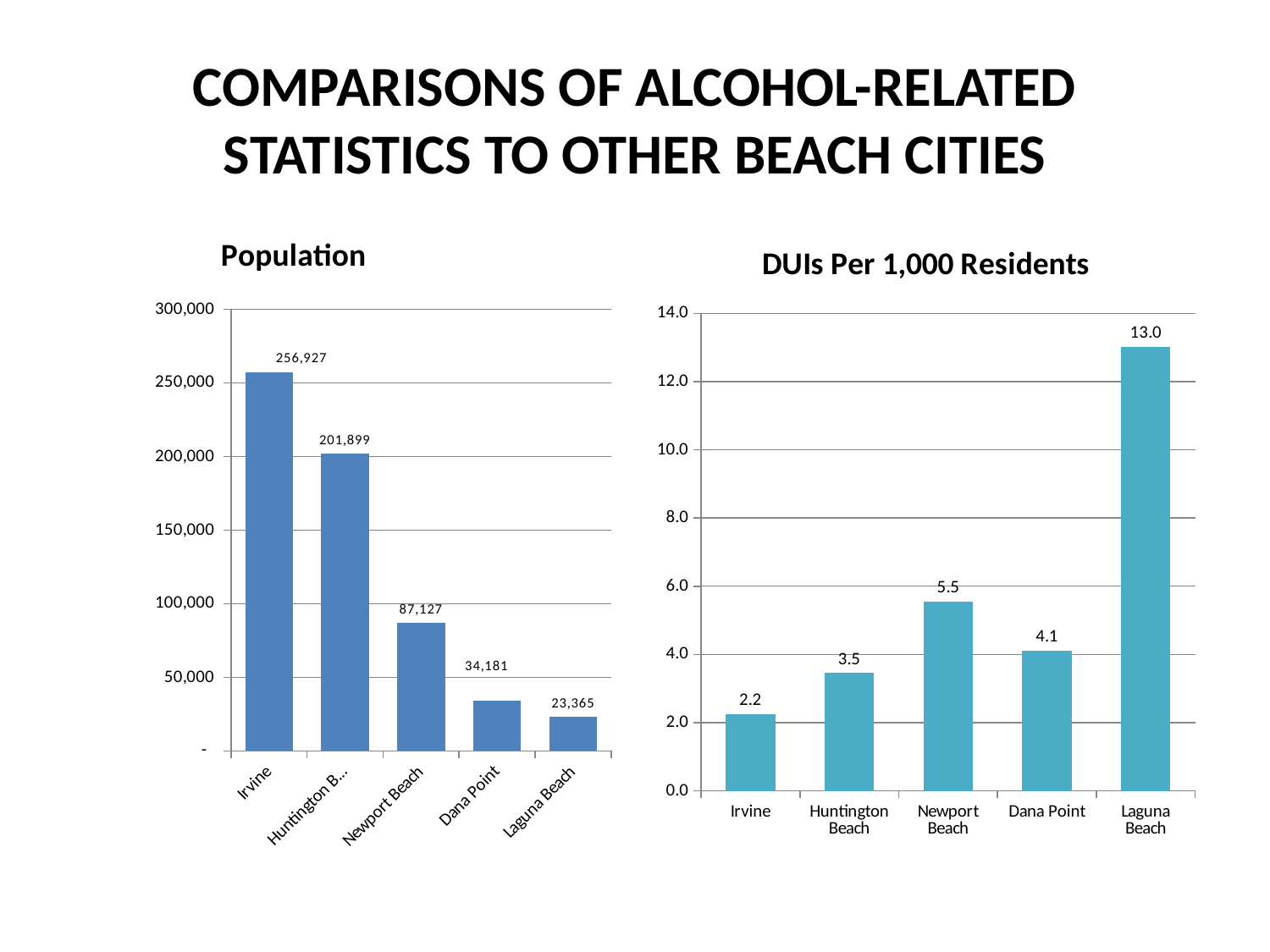
In the DUIs Per 1,000 Residents chart, what is the value for Laguna Beach? 13.0 In the Population chart, which city has the lowest population? Laguna Beach In the Population chart, is the value for Newport Beach greater or less than 100,000? less In the DUIs Per 1,000 Residents chart, what is the value for Newport Beach? 5.5 In the Population chart, what is the population of Newport Beach? 87,127 In the Population chart, what is the population of Irvine? 256,927 How many cities are shown in the DUIs Per 1,000 Residents chart? 5 In the DUIs Per 1,000 Residents chart, what is the difference between Laguna Beach and Irvine? 10.8 In the DUIs Per 1,000 Residents chart, which is larger, the value for Newport Beach or Dana Point? Newport Beach In the Population chart, what is the difference between the populations of Dana Point and Laguna Beach? 10,816 In the DUIs Per 1,000 Residents chart, which city has the lowest value? Irvine In the DUIs Per 1,000 Residents chart, which city has the highest value? Laguna Beach